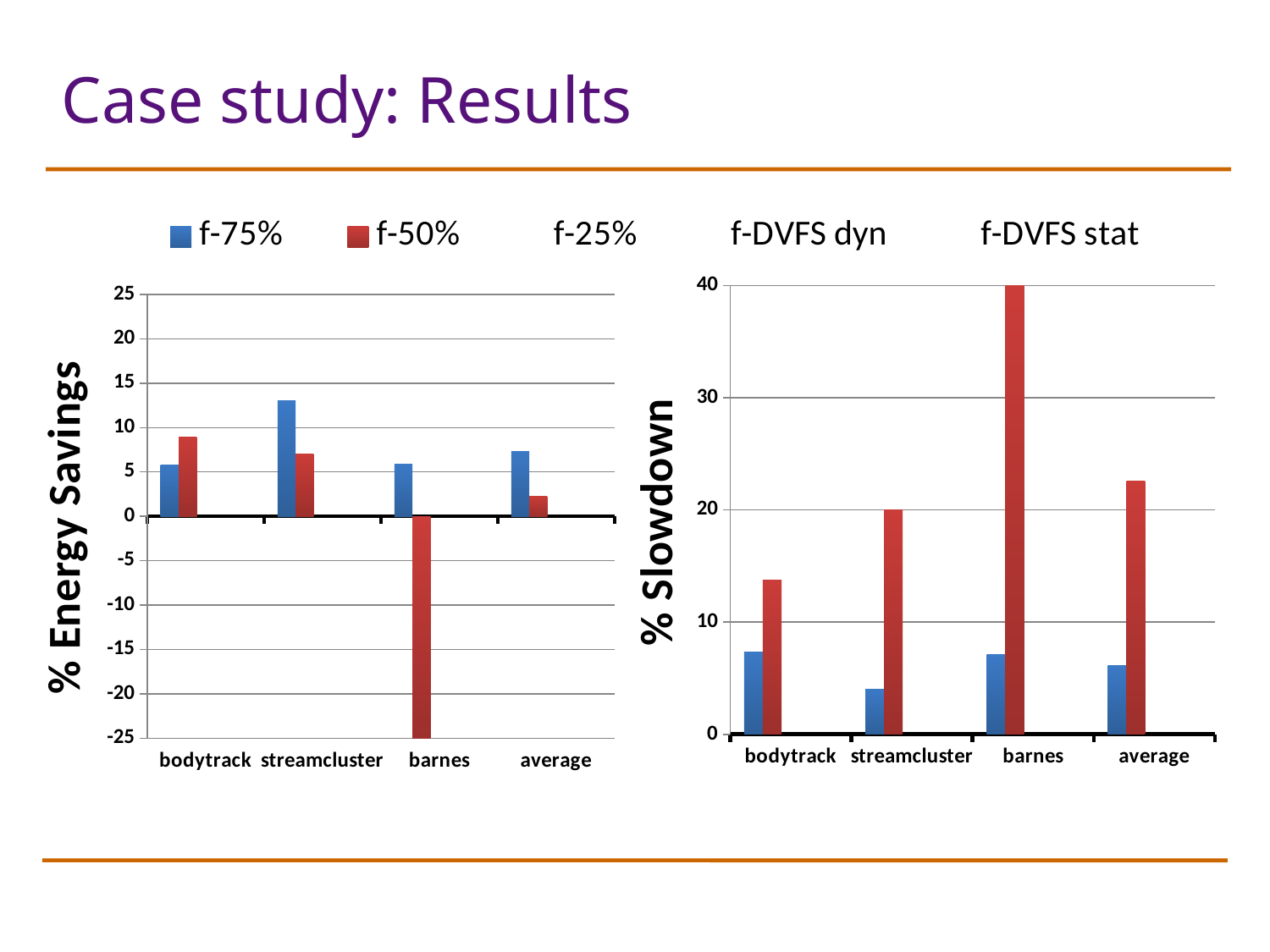
In the % Energy Savings chart, is the f-75% value for streamcluster greater or less than 10? greater In the % Energy Savings chart, which category has the highest f-75% value? streamcluster What is the y-axis title of the chart on the right? % Slowdown What kind of chart is the % Energy Savings chart on the left? bar chart In the % Slowdown chart, which category has the lowest f-75% value? streamcluster How many entries does the legend at the top of the slide list? 5 In the % Energy Savings chart, is the f-50% value for barnes greater or less than -20? less In the % Slowdown chart, which category has the highest f-50% value? barnes In the % Energy Savings chart, which category has the lowest f-50% value? barnes In the % Energy Savings chart, which is larger for bodytrack, f-75% or f-50%? f-50% How many categories are shown on the x axis of the % Slowdown chart? 4 In the % Slowdown chart, is the f-50% value for average greater or less than 20? greater